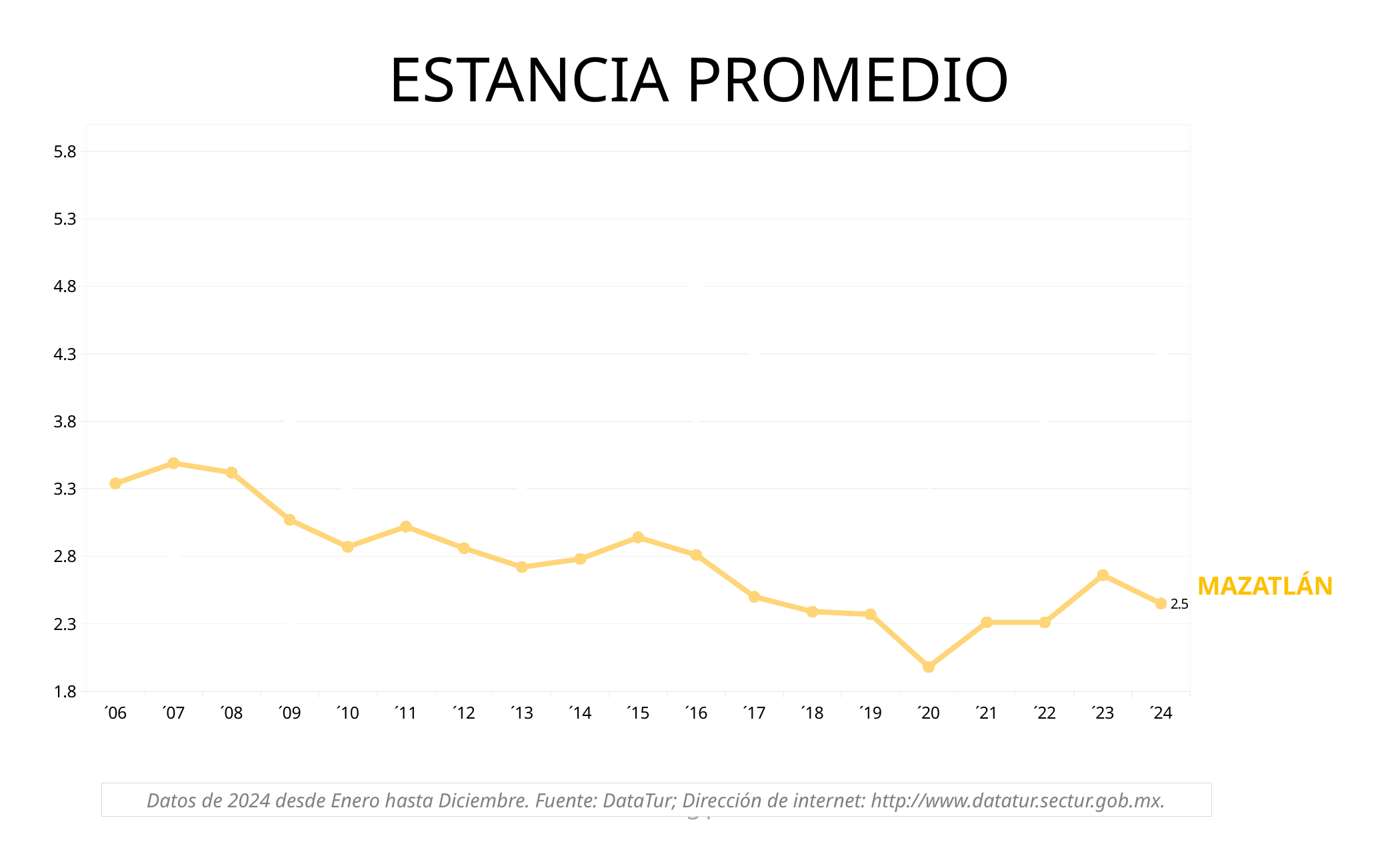
Is the value for ´09 greater or less than 3.3? less How many years (data points) are plotted on the x axis? 19 Which year has the highest value on the chart? ´07 Which year has the lowest value on the chart? ´20 Which is larger, the value for ´23 or the value for ´22? ´23 What kind of chart is shown on the slide? line chart Overall, do the values rise or fall from ´06 to ´24? fall Is the value for ´20 greater or less than 2.3? less What is the title of the chart? ESTANCIA PROMEDIO What is the value for ´24 on the MAZATLÁN line? 2.5 How many series are plotted on the chart? 1 Is the value for ´15 greater or less than 2.8? greater